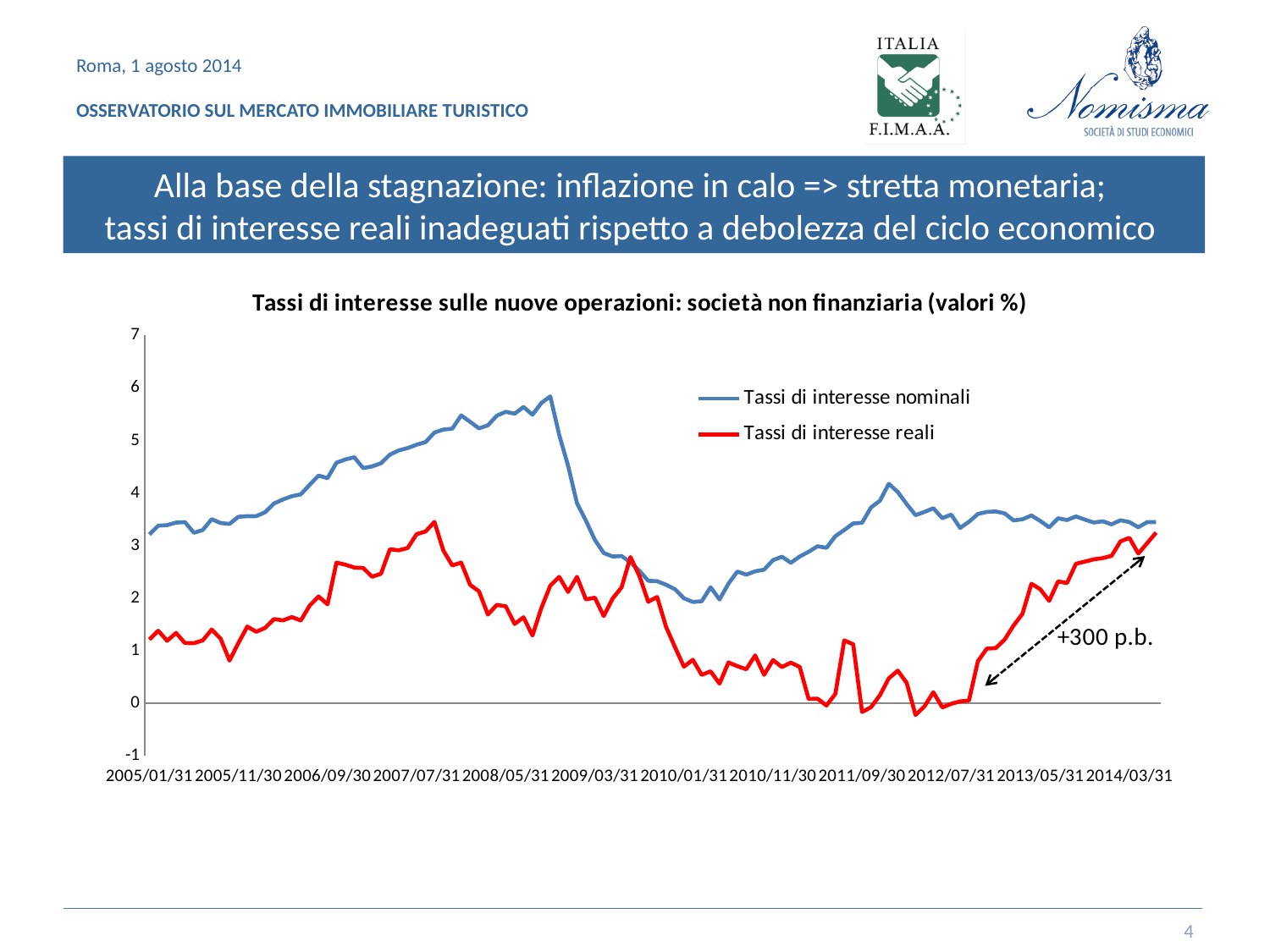
Is the value of Tassi di interesse nominali at 2014/03/31 greater or less than 3? greater Do the values of Tassi di interesse reali rise or fall between 2012/07/31 and 2014/03/31? rise How many date labels are shown on the x axis? 12 How many series does the legend list? 2 Which series is drawn in red? Tassi di interesse reali Is the value of Tassi di interesse reali at 2012/07/31 greater or less than 1? less What is the title of the chart? Tassi di interesse sulle nuove operazioni: società non finanziaria (valori %) Is the value of Tassi di interesse reali at 2014/03/31 greater or less than 2? greater What kind of chart is shown on the slide? Line chart Which series reaches the highest value anywhere on the chart? Tassi di interesse nominali At 2008/05/31, which series has the higher value, Tassi di interesse nominali or Tassi di interesse reali? Tassi di interesse nominali